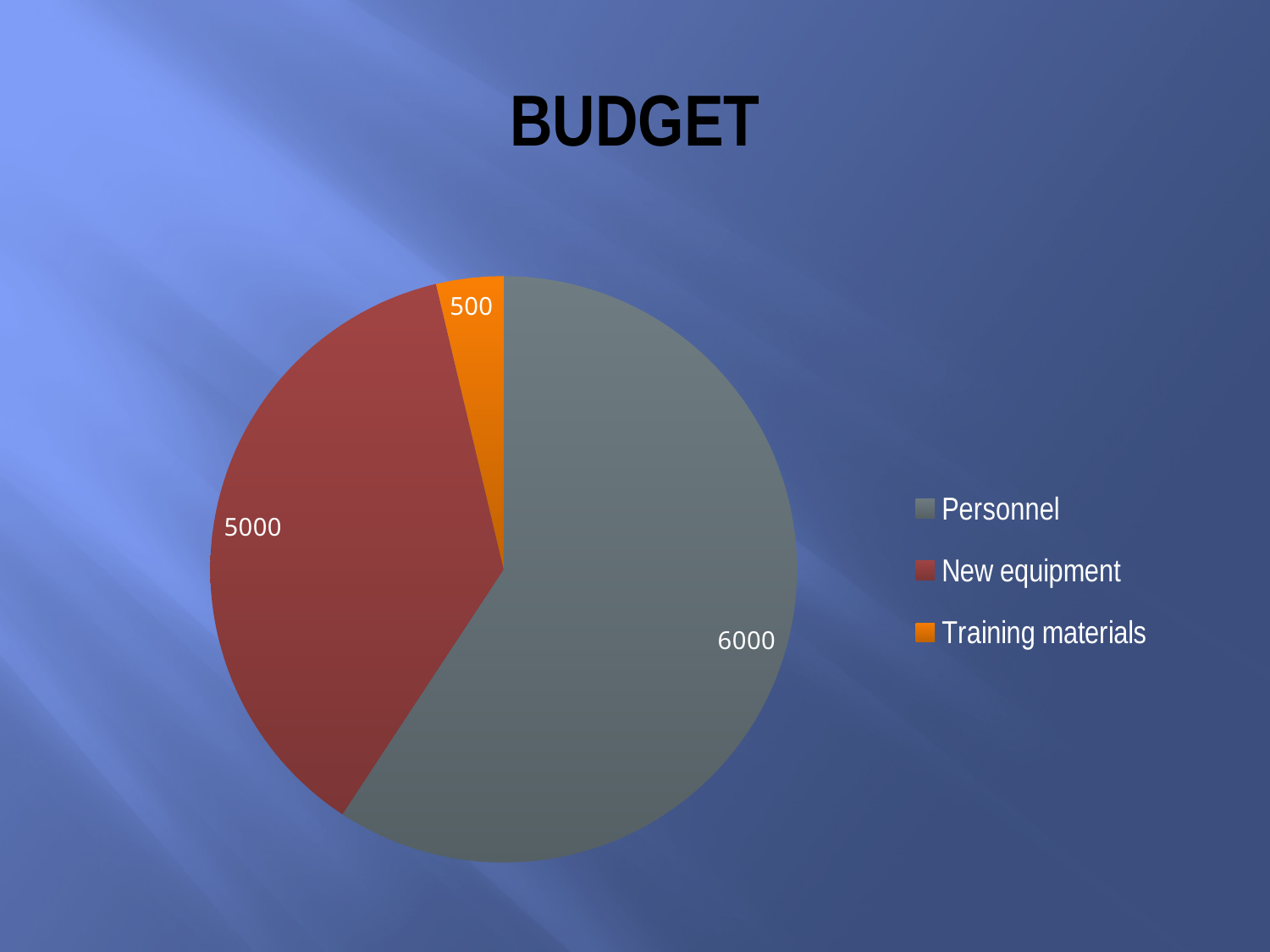
What is the difference between the values for Personnel and New equipment? 1000 Which category has the largest slice of the pie? Personnel How many categories are shown in the pie chart? 3 What is the difference between the values for New equipment and Training materials? 4500 What is the value for New equipment? 5000 What is the total of all the slices in the pie chart? 11500 What kind of chart is shown on the slide? Pie chart Which is larger, the value for Personnel or the value for New equipment? Personnel What is the value for Personnel? 6000 What is the value for Training materials? 500 What is the title of the chart? BUDGET Which category has the smallest slice of the pie? Training materials